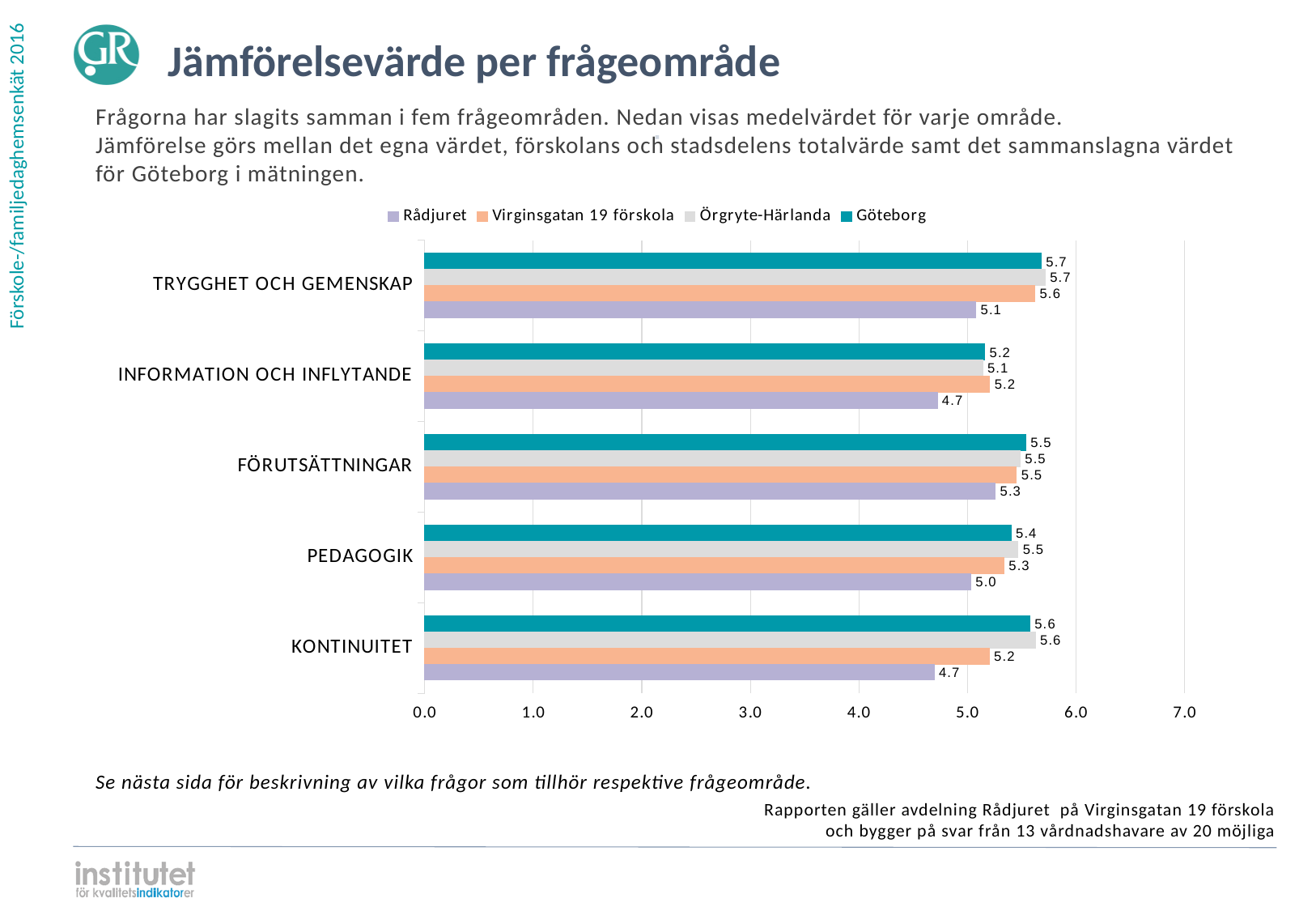
What is the value for Virginsgatan 19 förskola in the PEDAGOGIK category? 5.3 Which series is shown in purple in the legend? Rådjuret In which category does Rådjuret have its highest value? FÖRUTSÄTTNINGAR How many series does the legend list? 4 What type of chart is shown on the slide? bar chart What is the value for Rådjuret in the TRYGGHET OCH GEMENSKAP category? 5.1 How many question areas (categories) are shown on the chart? 5 What is the difference between the Örgryte-Härlanda value and the Rådjuret value in the TRYGGHET OCH GEMENSKAP category? 0.6 What is the value for Göteborg in the KONTINUITET category? 5.6 What is the difference between the Göteborg value and the Rådjuret value in the KONTINUITET category? 0.9 In the PEDAGOGIK category, which is larger: the value for Örgryte-Härlanda or the value for Rådjuret? Örgryte-Härlanda What is the value for Örgryte-Härlanda in the INFORMATION OCH INFLYTANDE category? 5.1